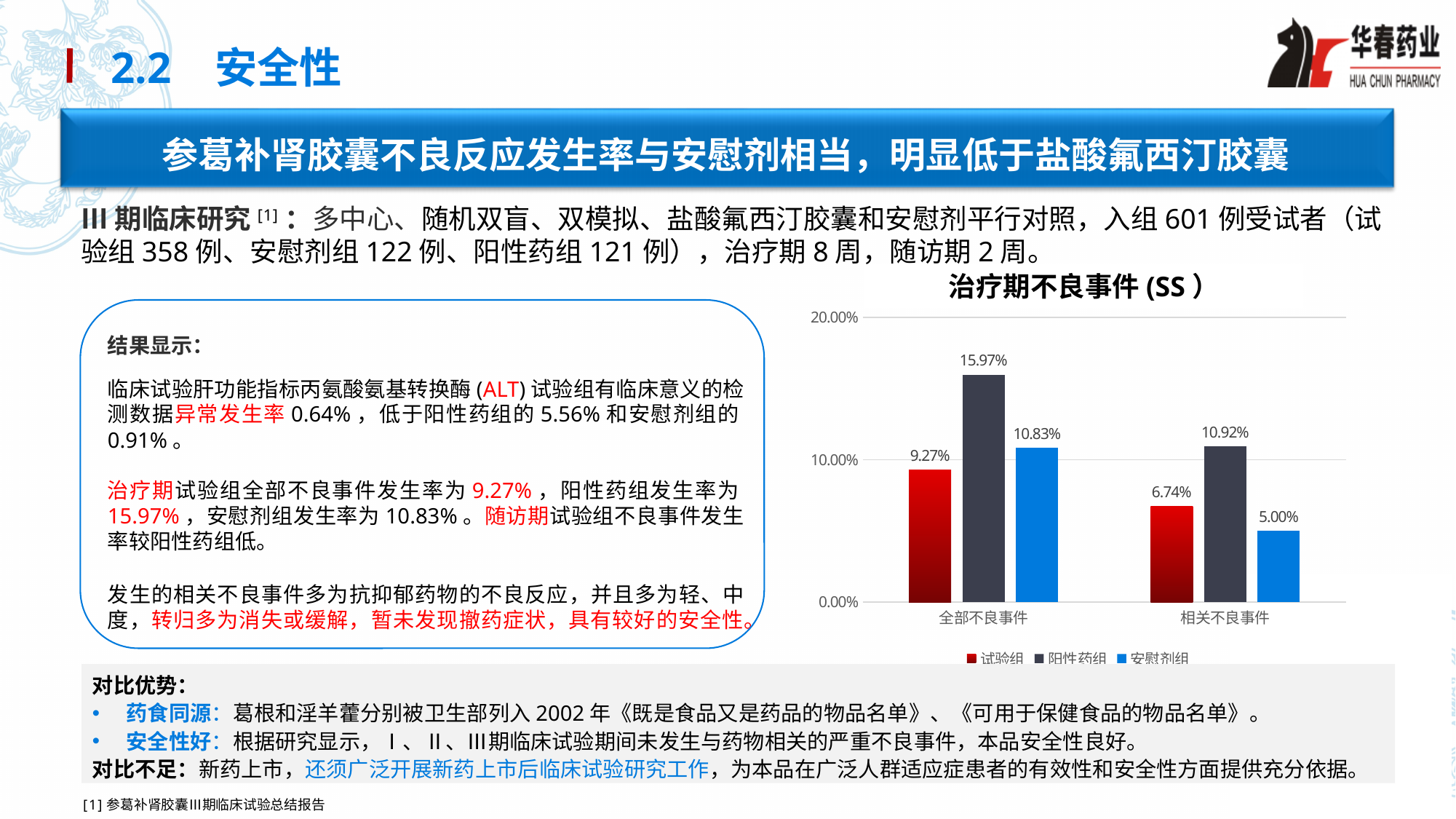
图表“治疗期不良事件 (SS）”中，相关不良事件的阳性药组数值是多少？ 10.92% 图表“治疗期不良事件 (SS）”中，全部不良事件的安慰剂组与试验组，哪个数值更大？ 安慰剂组 图表“治疗期不良事件 (SS）”中，全部不良事件的试验组数值是多少？ 9.27% 图表“治疗期不良事件 (SS）”的图例列出了几个系列？ 3 图表“治疗期不良事件 (SS）”是什么类型的图表？ 柱状图（条形图） 图表“治疗期不良事件 (SS）”中，试验组用什么颜色表示？ 红色 图表“治疗期不良事件 (SS）”中，全部不良事件的阳性药组与试验组数值相差多少？ 6.70% 图表“治疗期不良事件 (SS）”中，相关不良事件的安慰剂组数值是多少？ 5.00% 图表“治疗期不良事件 (SS）”中，相关不良事件的试验组与安慰剂组数值相差多少？ 1.74% 图表“治疗期不良事件 (SS）”中，全部不良事件类别下哪个组的数值最高？ 阳性药组 图表“治疗期不良事件 (SS）”中，全部不良事件的阳性药组数值是多少？ 15.97% 图表“治疗期不良事件 (SS）”中，相关不良事件类别下哪个组的数值最低？ 安慰剂组